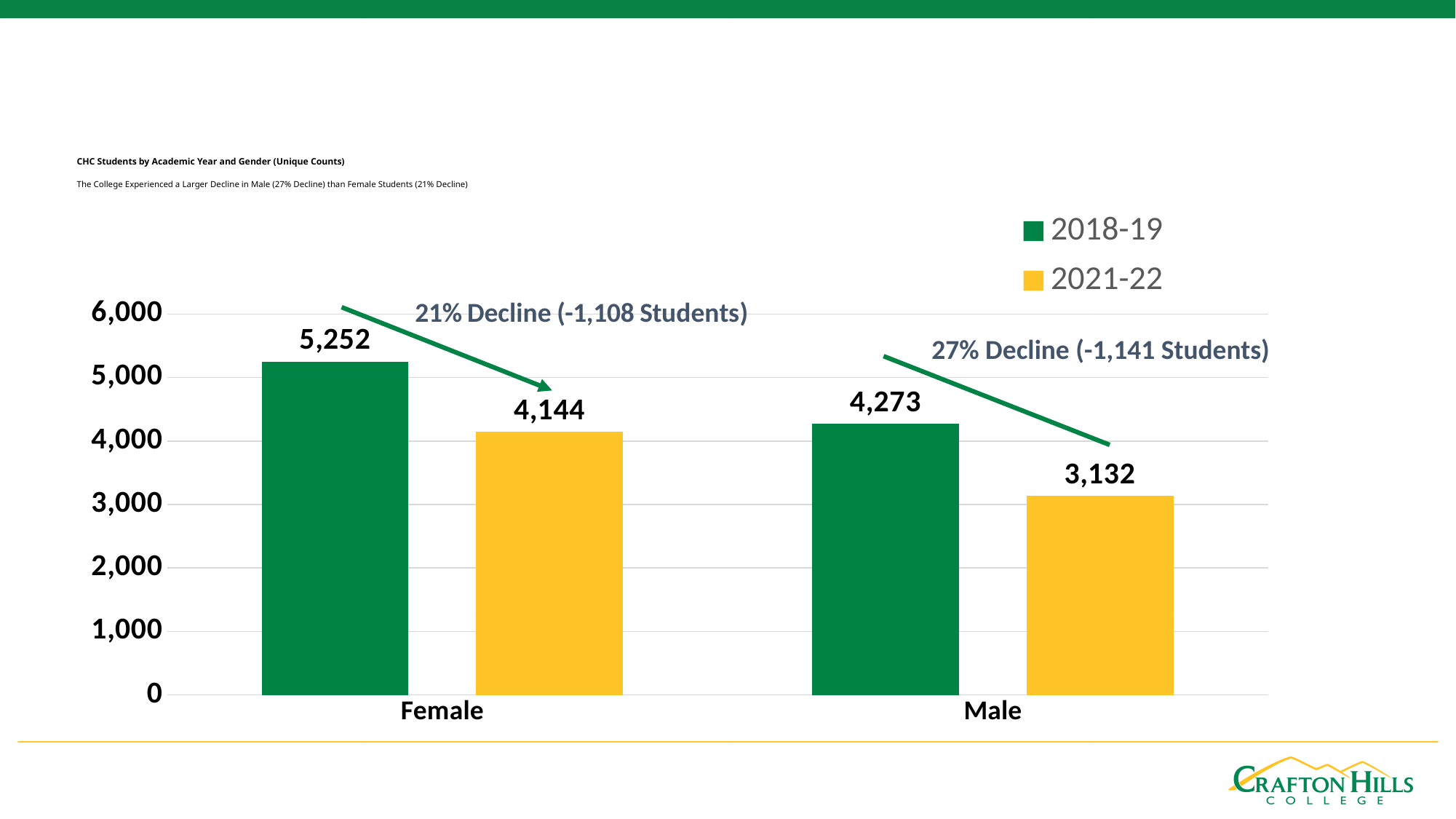
What was the number of male students in 2018-19? 4,273 What is the difference between female students in 2018-19 and 2021-22? 1,108 What was the number of female students in 2021-22? 4,144 Which bar shows the highest value on the chart? Female, 2018-19 What was the number of male students in 2021-22? 3,132 What colour represents the 2021-22 series? Yellow What is the difference between male students in 2018-19 and 2021-22? 1,141 What kind of chart is shown on the slide? Bar chart Which is larger: female students in 2021-22 or male students in 2018-19? Male students in 2018-19 How many series does the legend list? 2 Which bar shows the lowest value on the chart? Male, 2021-22 What was the number of female students in 2018-19? 5,252